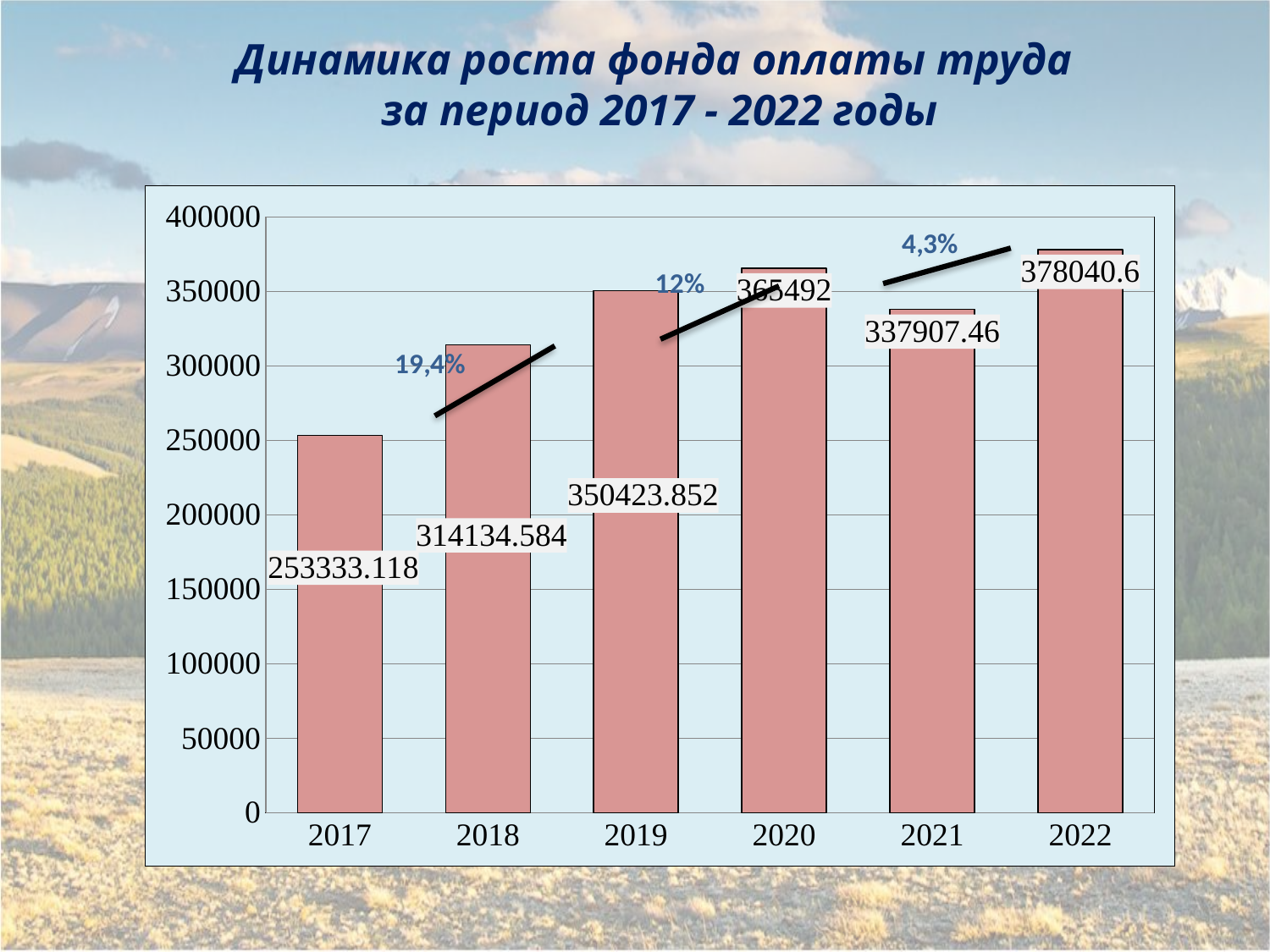
What kind of chart is shown on the slide? bar chart What is the value for 2017? 253333.118 Is the value for 2018 greater or less than 300000? greater What is the value for 2020? 365492 Did the value rise or fall from 2020 to 2021? fall What is the value for 2021? 337907.46 Which is larger, the value for 2019 or the value for 2021? 2019 What is the value for 2022? 378040.6 How many years are shown on the x axis? 6 What is the difference between the values for 2020 and 2021? 27584.54 Which year has the lowest value? 2017 Which year has the highest value? 2022